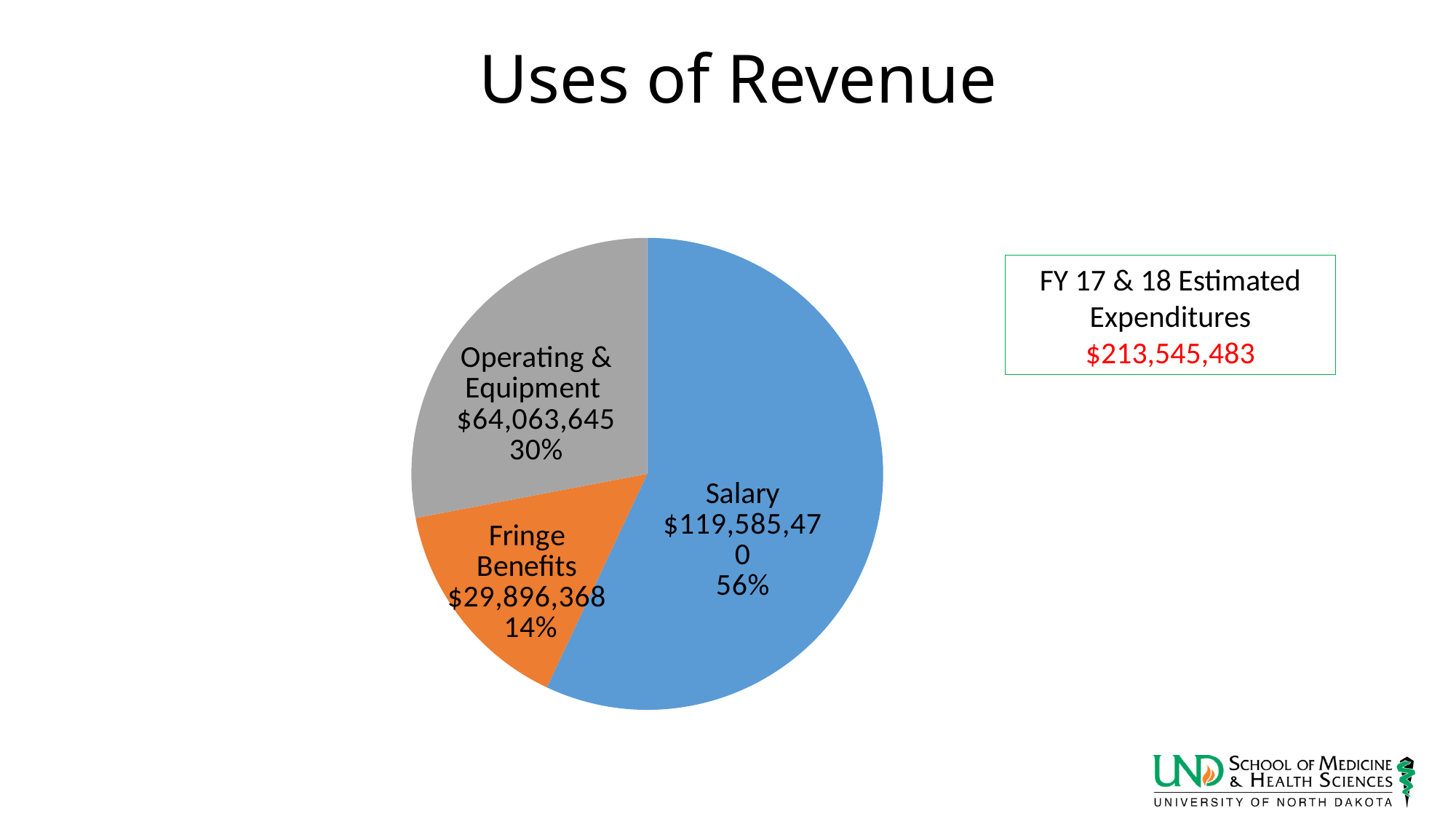
What is the difference in dollars between the Operating & Equipment slice and the Fringe Benefits slice? $34,167,277 What share of the pie does Fringe Benefits represent? 14% Which category has the largest slice of the pie? Salary What type of chart is shown on the slide? Pie chart What share of the pie does Salary represent? 56% What share of the pie does Operating & Equipment represent? 30% What is the dollar value of the Fringe Benefits slice? $29,896,368 What is the dollar value of the Operating & Equipment slice? $64,063,645 Which category has the smallest slice of the pie? Fringe Benefits Which is larger, Operating & Equipment or Fringe Benefits? Operating & Equipment How many categories are shown in the pie chart? 3 What is the dollar value of the Salary slice? $119,585,470